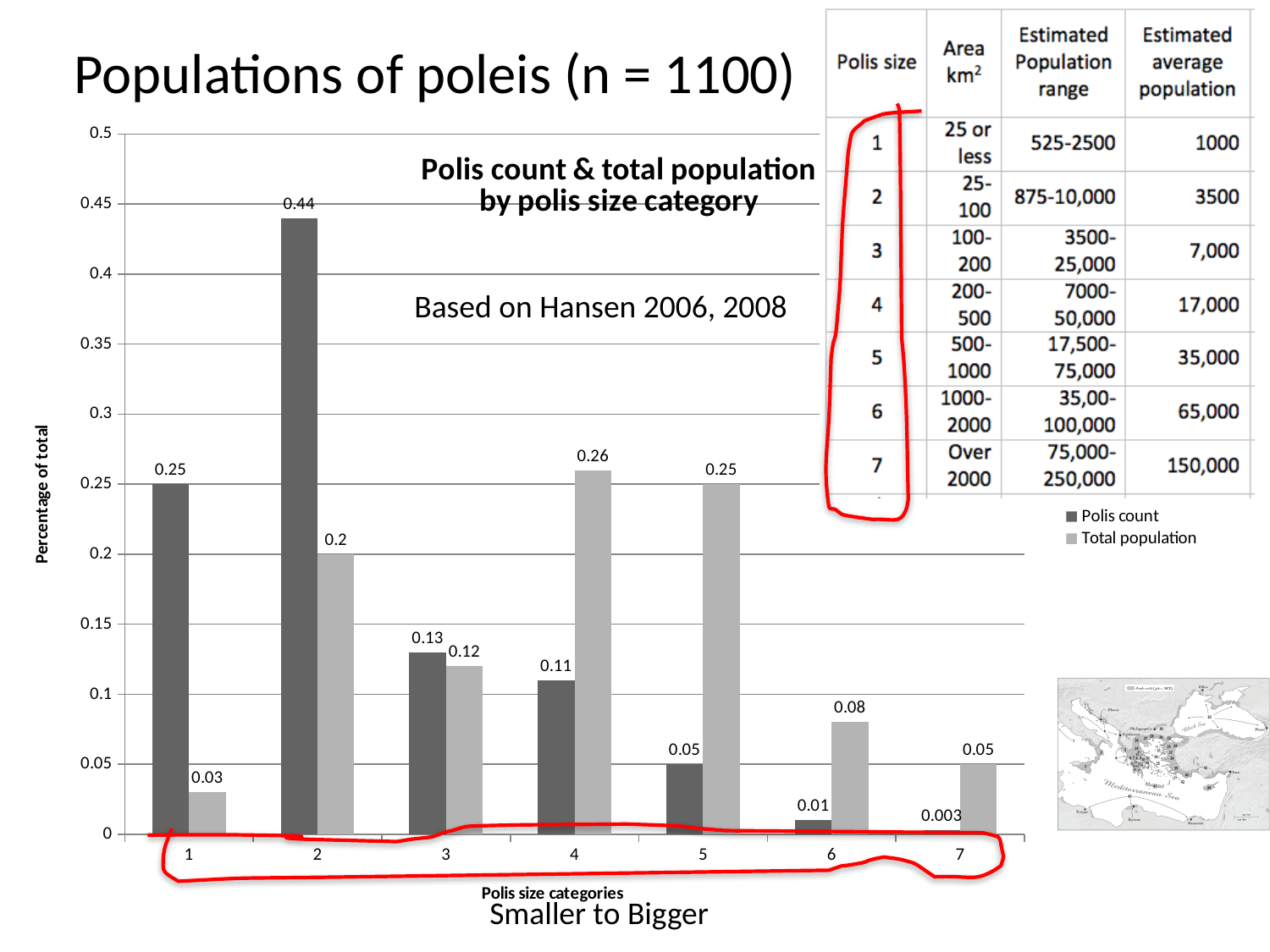
Which polis size category has the highest Polis count value? 2 What is the difference between the Polis count and Total population values for polis size category 1? 0.22 How many polis size categories are shown on the x axis? 7 Is the Total population value for polis size category 2 greater or less than 0.15? greater What kind of chart is shown on the slide? Bar chart For polis size category 5, which series has the larger value, Polis count or Total population? Total population What is the Polis count value for polis size category 2? 0.44 How many series does the legend list? 2 What is the Total population value for polis size category 4? 0.26 Which polis size category has the lowest Total population value? 1 What is the label of the y axis of the chart? Percentage of total What is the Polis count value for polis size category 7? 0.003